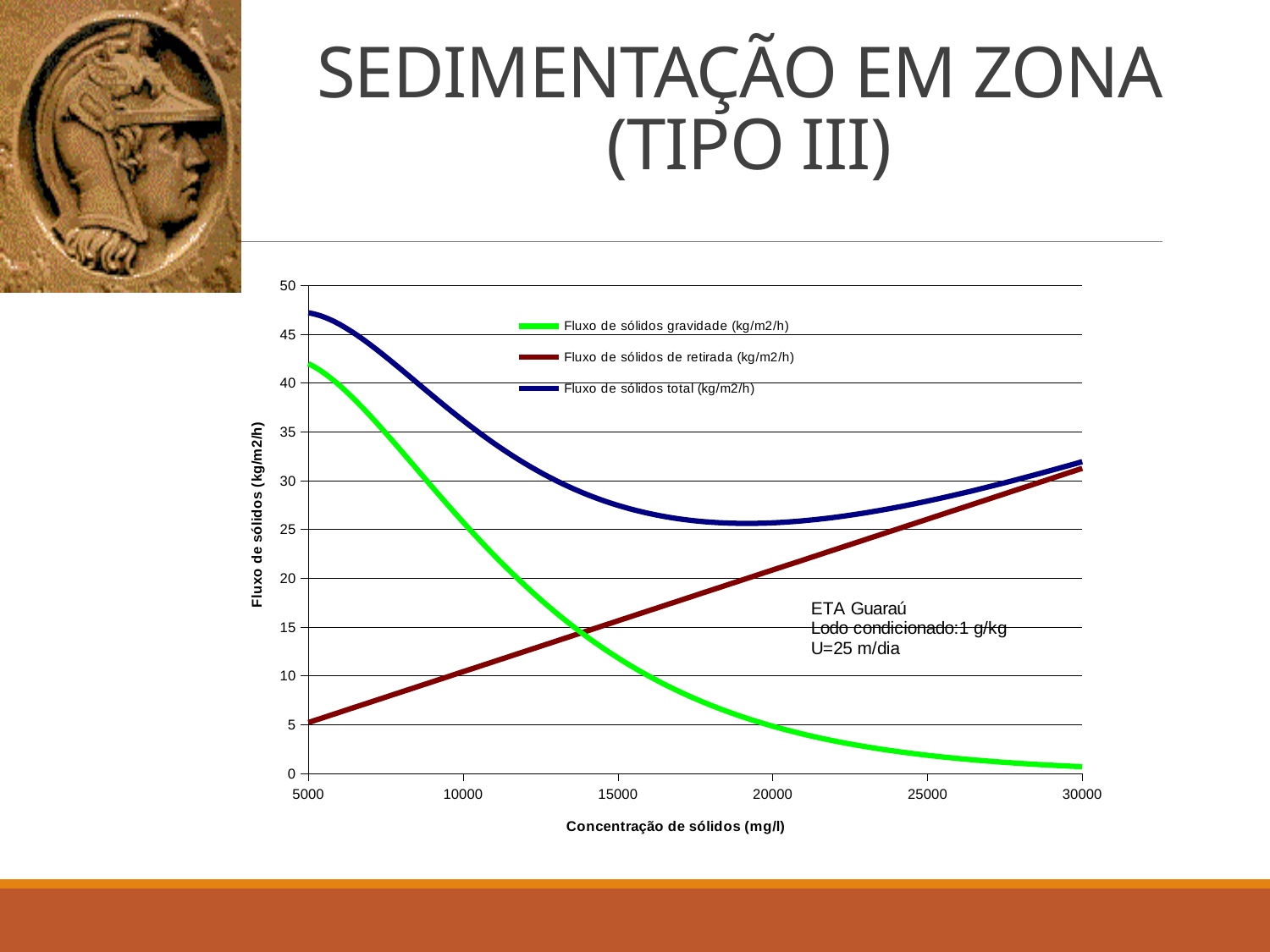
At 30000 mg/l, which is larger: Fluxo de sólidos de retirada or Fluxo de sólidos gravidade? Fluxo de sólidos de retirada At 10000 mg/l, which is larger: Fluxo de sólidos gravidade or Fluxo de sólidos de retirada? Fluxo de sólidos gravidade Which series is drawn in green? Fluxo de sólidos gravidade (kg/m2/h) How many series does the legend list? 3 Does the Fluxo de sólidos gravidade series rise or fall as concentration increases along the x axis? fall Is the value of Fluxo de sólidos gravidade at 30000 mg/l greater or less than 5? less Is the value of Fluxo de sólidos gravidade at 5000 mg/l greater or less than 40? greater Is the value of Fluxo de sólidos de retirada at 30000 mg/l greater or less than 30? greater Does the Fluxo de sólidos de retirada series rise or fall as concentration increases along the x axis? rise What kind of chart is shown on the slide? line chart What is the title of the x axis? Concentração de sólidos (mg/l)